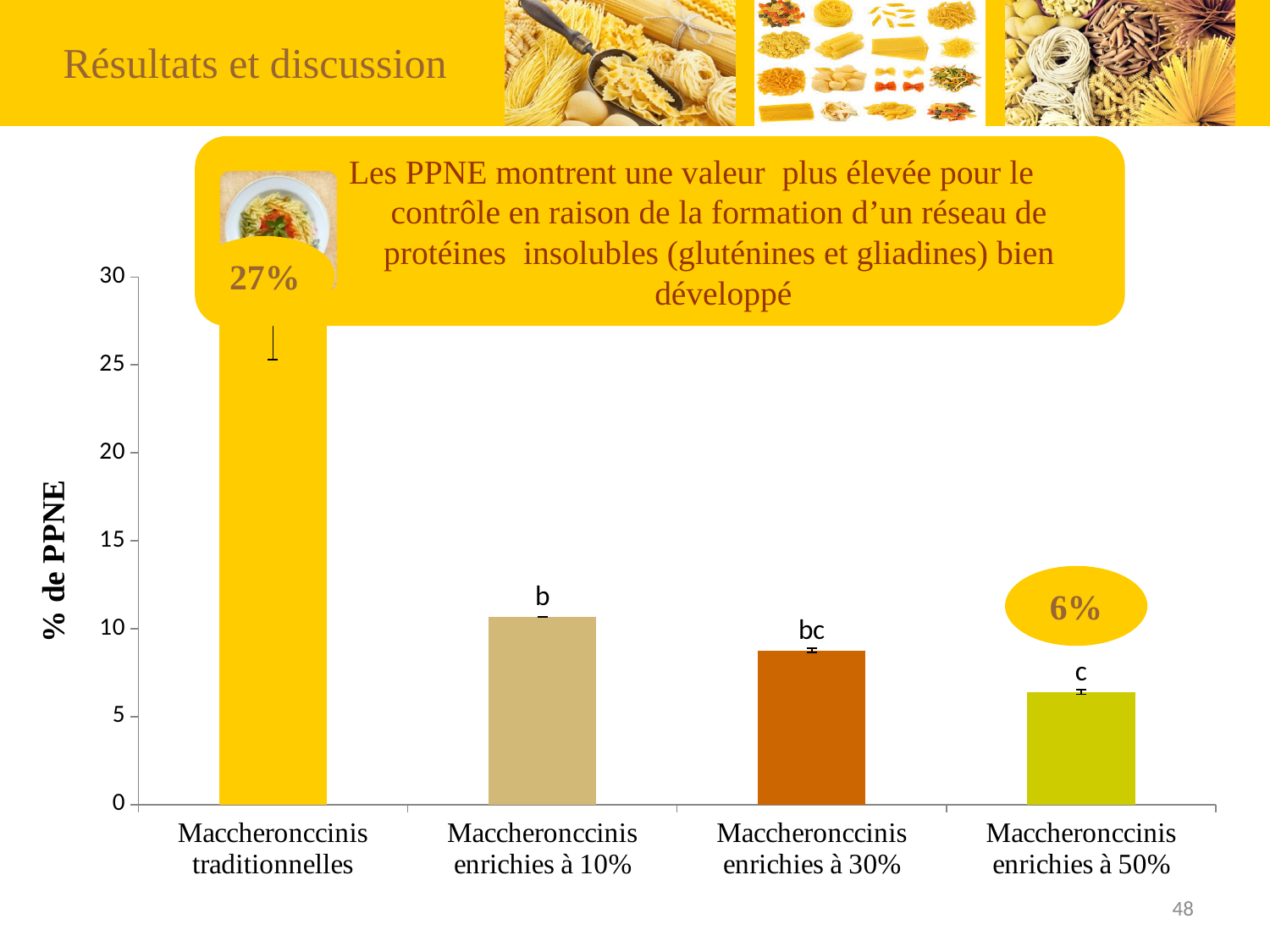
What letter is printed above the bar for Maccheronccinis enrichies à 30%? bc Do the values rise or fall moving from left to right along the x axis? fall What kind of chart is shown on the slide? bar chart Which category has the lowest % de PPNE? Maccheronccinis enrichies à 50% Is the value for Maccheronccinis enrichies à 50% greater or less than 5? greater Is the value for Maccheronccinis traditionnelles greater or less than 25? greater Which is larger: the value for Maccheronccinis enrichies à 10% or for Maccheronccinis enrichies à 30%? Maccheronccinis enrichies à 10% Is the value for Maccheronccinis enrichies à 30% greater or less than 10? less Which category has the highest % de PPNE? Maccheronccinis traditionnelles How many categories (bars) does the chart show? 4 What is the label of the y axis? % de PPNE